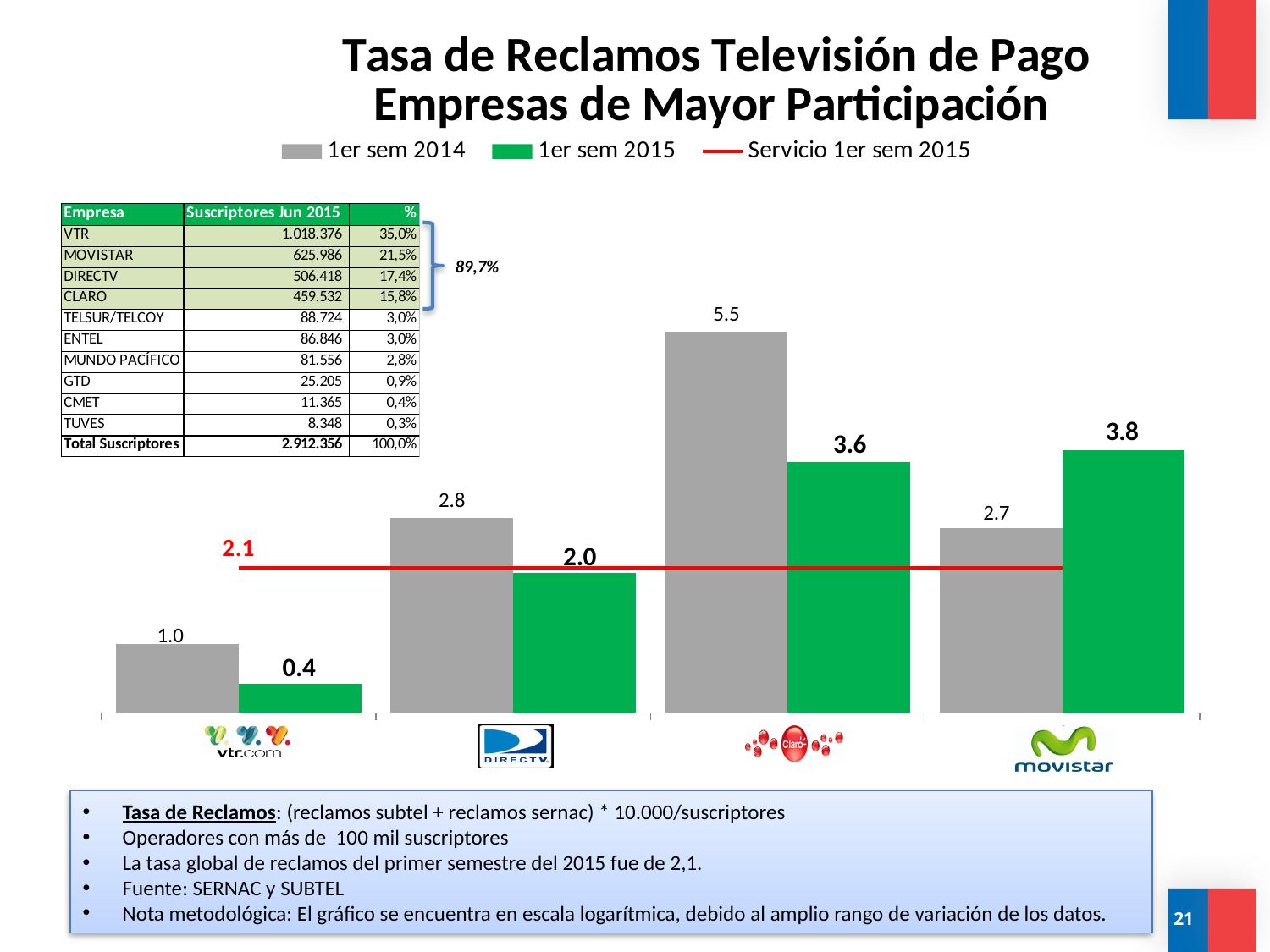
What value does the red 'Servicio 1er sem 2015' line mark? 2.1 Which company has the highest value in the 1er sem 2014 series? Claro What is the value for Claro in the 1er sem 2014 series? 5.5 What is the difference between the 1er sem 2014 and 1er sem 2015 values for Claro? 1.9 How many companies are shown on the x axis of the chart? 4 What is the value for VTR in the 1er sem 2015 series? 0.4 What is the value for Movistar in the 1er sem 2015 series? 3.8 How many series does the legend list? 3 What kind of chart is shown on the slide? Combination bar and line chart What is the value for DIRECTV in the 1er sem 2014 series? 2.8 For Movistar, which is larger: the 1er sem 2014 value or the 1er sem 2015 value? 1er sem 2015 Which company has the lowest value in the 1er sem 2015 series? VTR